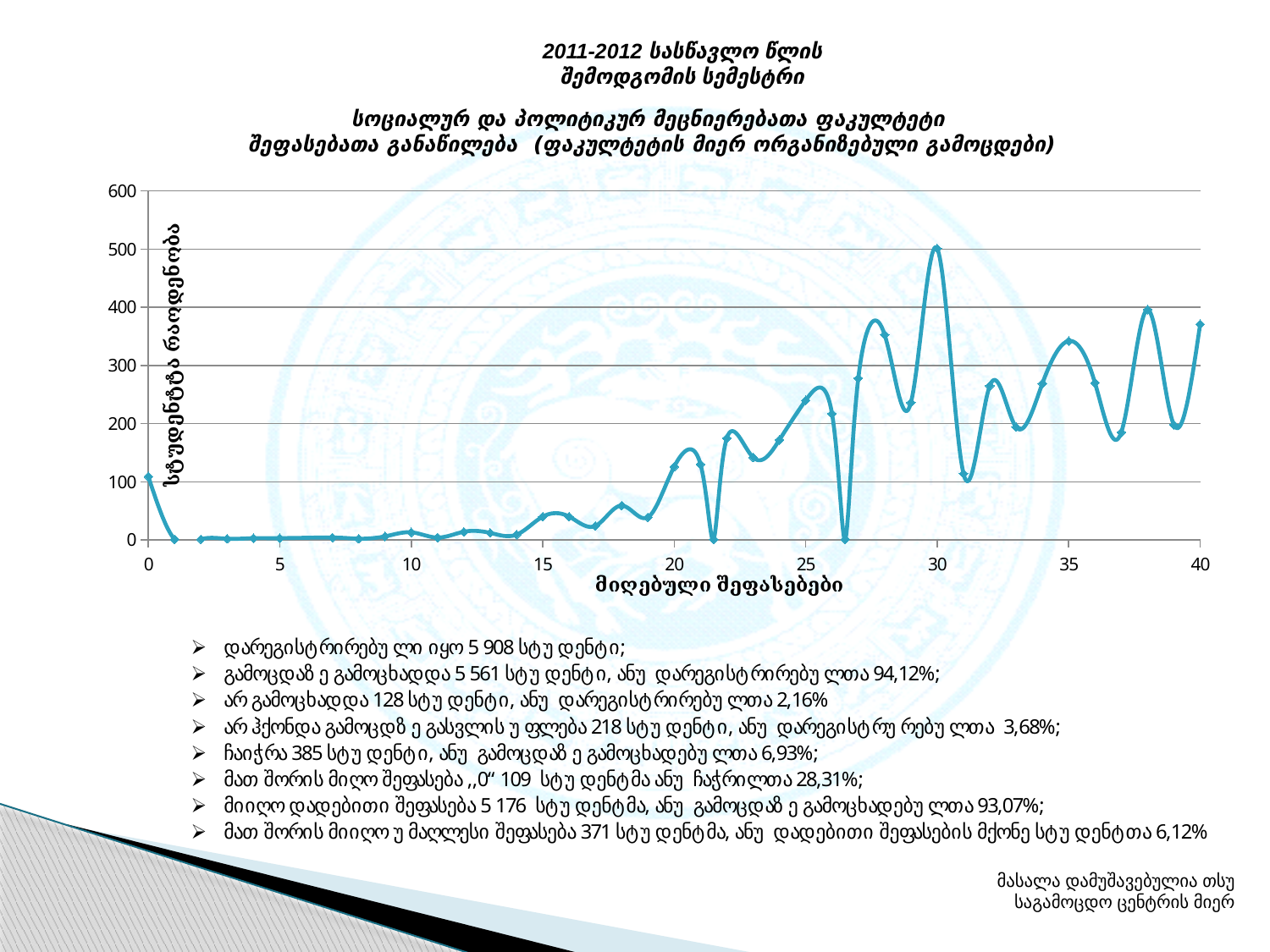
What is the highest tick value shown on the y axis? 600 Which has the larger value, score 0 or score 1? 0 Is the value at score 38 greater or less than 300? greater Is the value at score 27 greater or less than 200? greater Overall, do the values rise or fall as the score increases from 0 to 40? rise Is the value at score 10 greater or less than 100? less At which score on the x axis does the line reach its highest value? 30 Which has the larger value, score 30 or score 40? 30 What kind of chart is shown on the slide? line chart